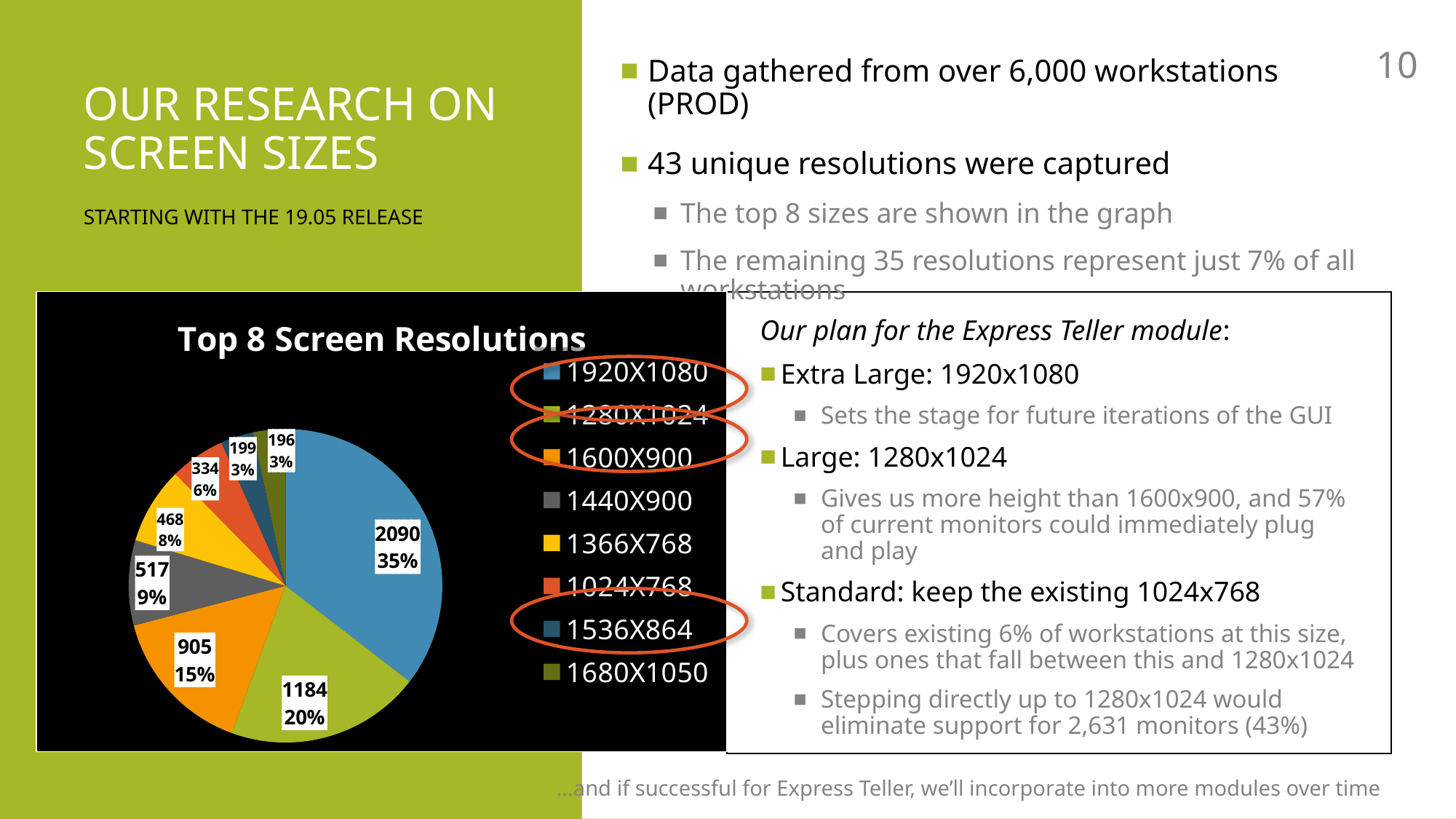
What colour is the 1680X1050 slice in the legend? olive green Which has a larger count, 1366X768 or 1024X768? 1366X768 What is the title of the chart? Top 8 Screen Resolutions What is the count shown for the 1920X1080 slice? 2090 What kind of chart is shown on the slide? pie chart What percentage share does the 1280X1024 slice have? 20% What is the count shown for the 1600X900 slice? 905 Which resolution has the largest slice of the pie? 1920X1080 What is the difference between the counts for 1920X1080 and 1280X1024? 906 What percentage share does the 1440X900 slice have? 9% What is the count shown for the 1536X864 slice? 199 How many slices does the pie chart have? 8